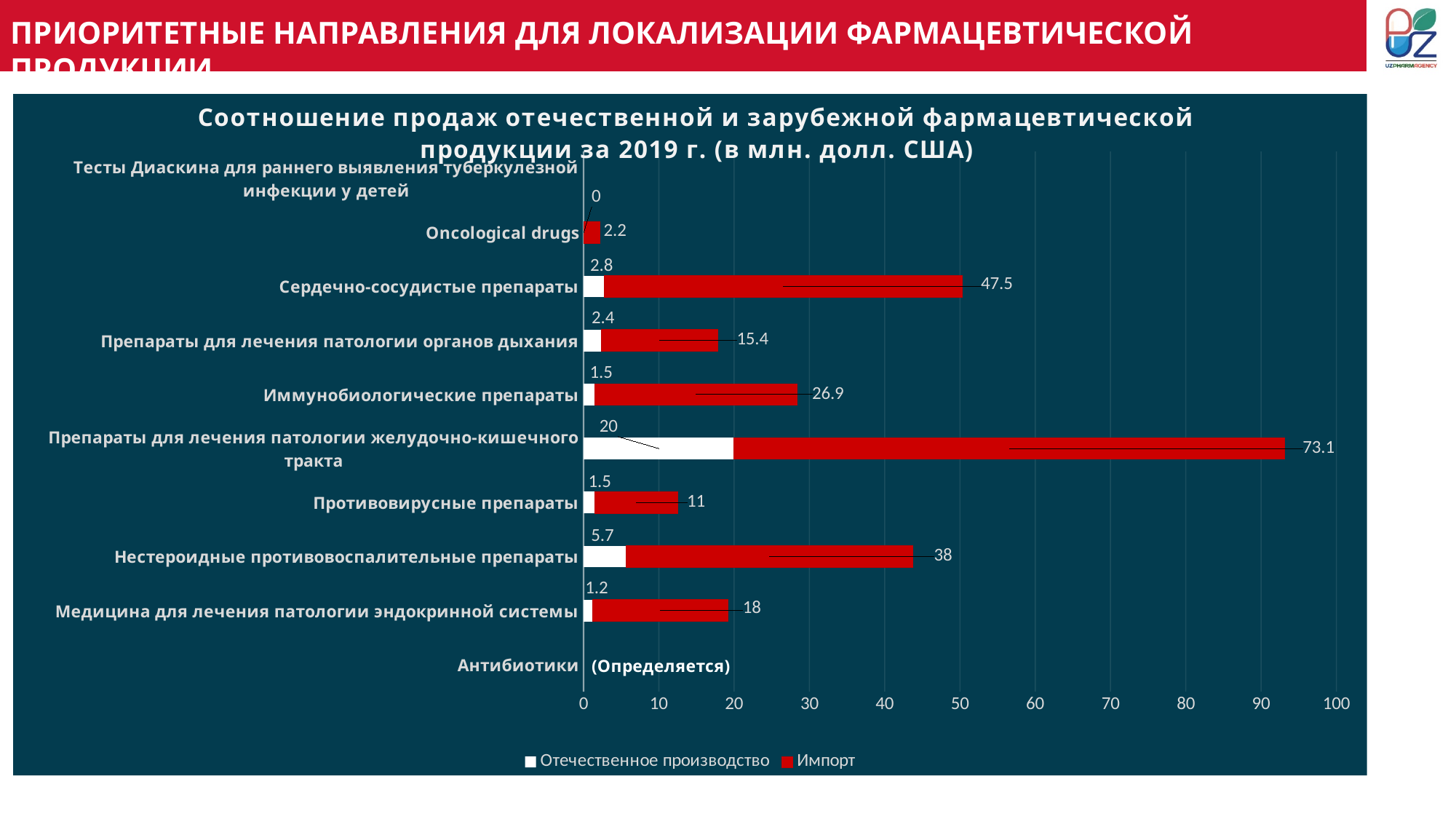
Which category has the highest domestic production value? Препараты для лечения патологии желудочно-кишечного тракта What is the import (Импорт) value for Сердечно-сосудистые препараты? 47.5 How many series does the legend list? 2 What is the difference between the import values for Иммунобиологические препараты and Противовирусные препараты? 15.9 Which category has the highest import value? Препараты для лечения патологии желудочно-кишечного тракта What is the import value for Нестероидные противовоспалительные препараты? 38 Which is larger: the import value for Препараты для лечения патологии органов дыхания or for Медицина для лечения патологии эндокринной системы? Медицина для лечения патологии эндокринной системы What is shown instead of a value for Антибиотики? (Определяется) What are the two series named in the legend? Отечественное производство, Импорт What is the domestic production (Отечественное производство) value for Препараты для лечения патологии желудочно-кишечного тракта? 20 What type of chart is shown on the slide? bar chart What is the total of the stacked bar for Сердечно-сосудистые препараты? 50.3